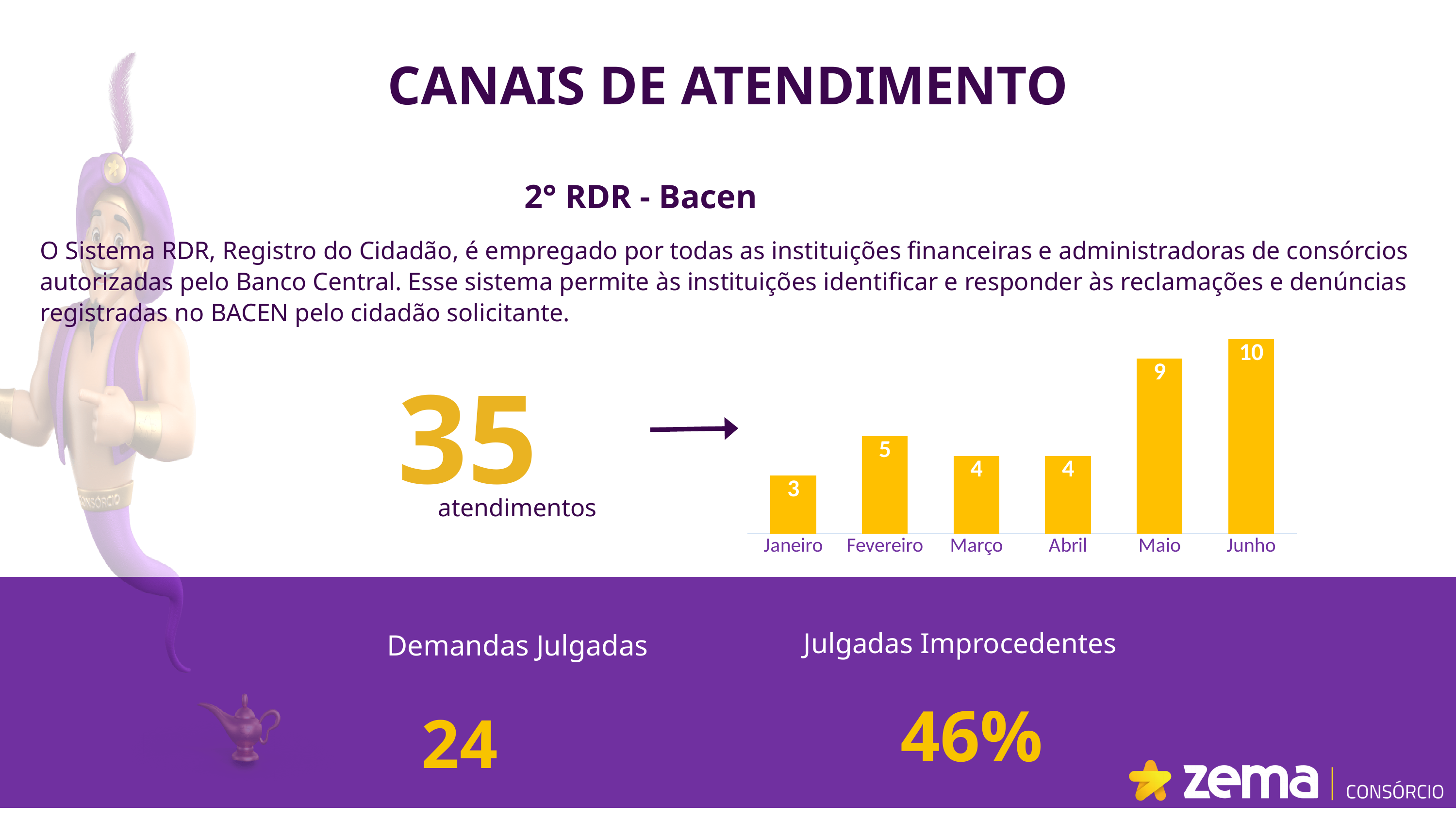
What is the value for Fevereiro in the bar chart? 5 What is the value for Maio in the bar chart? 9 Which is larger, the value for Fevereiro or the value for Março? Fevereiro Which month has the lowest value in the bar chart? Janeiro Do the values in the bar chart rise or fall from Abril to Junho? rise What is the difference between the values for Maio and Abril? 5 Which month has the highest value in the bar chart? Junho What kind of chart is shown on the slide? bar chart What colour are the bars in the chart? yellow How many months are shown in the bar chart? 6 What is the difference between the values for Junho and Janeiro? 7 What is the value for Janeiro in the bar chart? 3